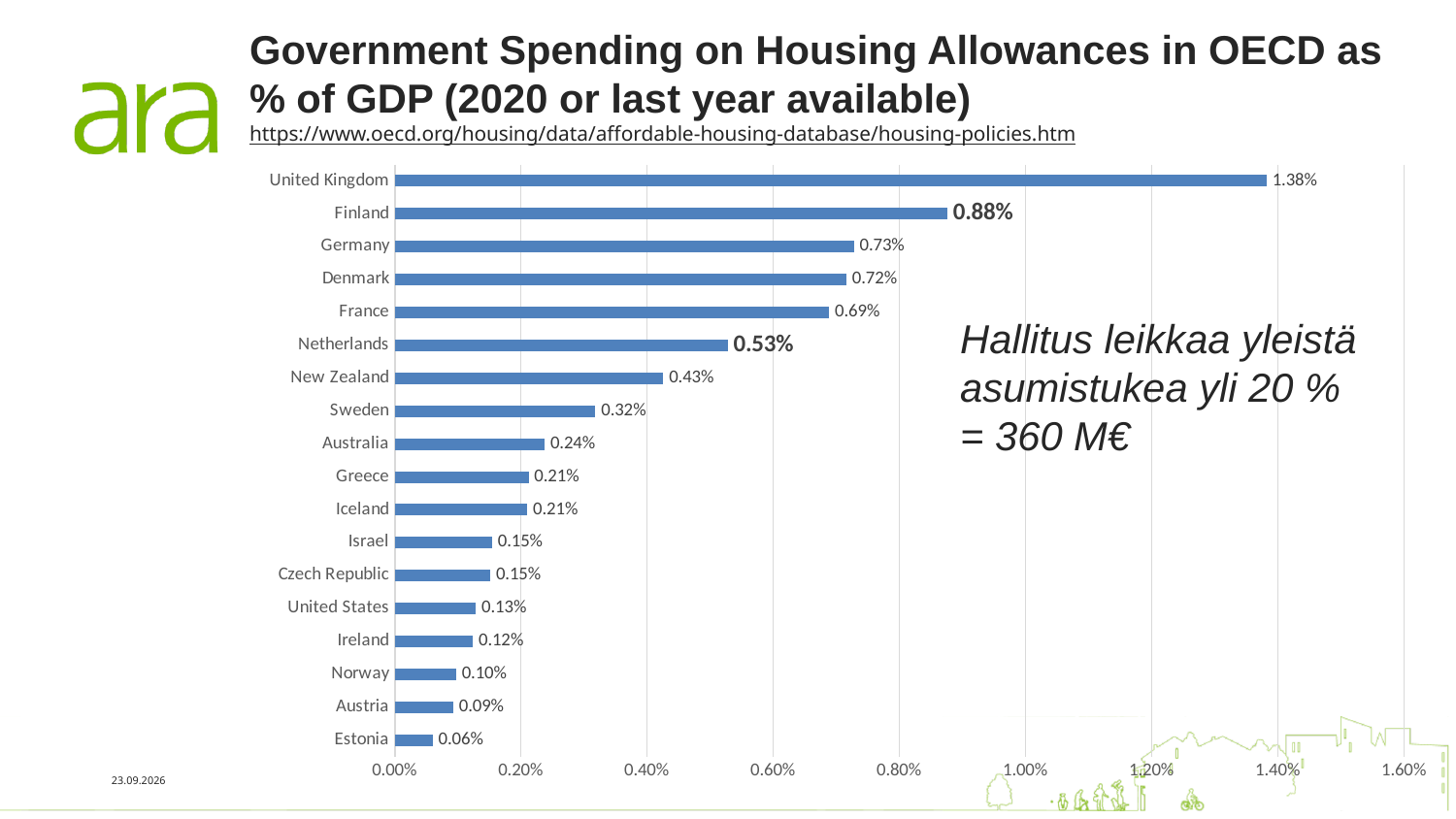
What kind of chart is shown on the slide? Bar chart What is the value for Finland? 0.88% Which country has the lowest value? Estonia Which country has the highest value? United Kingdom What is the value for Sweden? 0.32% What is the title of the chart? Government Spending on Housing Allowances in OECD as % of GDP (2020 or last year available) What is the difference between the values for the United Kingdom and Finland? 0.50% Which is larger, the value for Germany or the value for France? Germany What is the difference between the values for Denmark and Norway? 0.62% What is the value for the Netherlands? 0.53% Is the value for New Zealand greater or less than 0.40%? greater How many countries are shown in the chart? 18